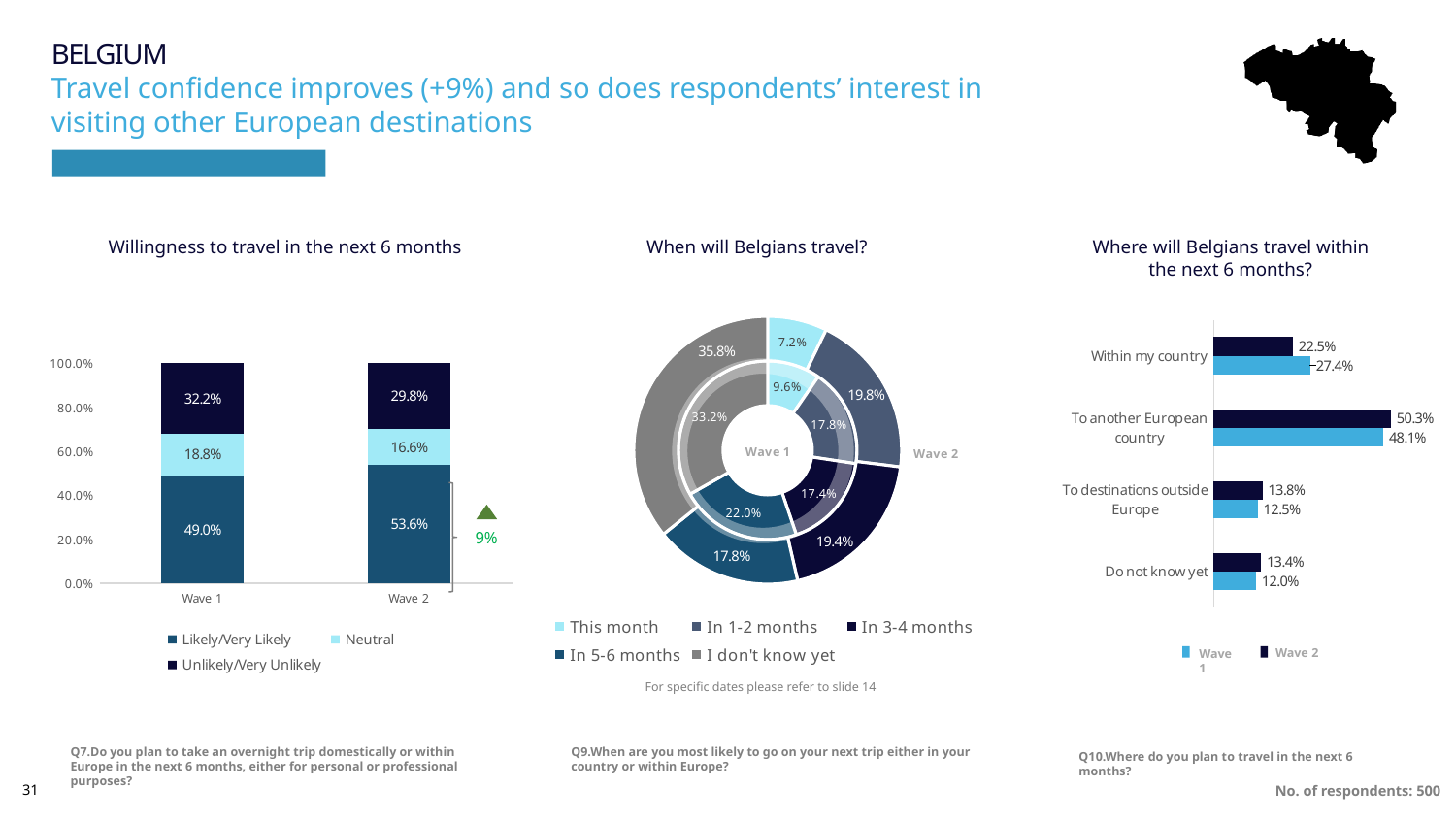
In the 'Where will Belgians travel within the next 6 months?' chart, how many categories are shown? 4 In the 'Where will Belgians travel within the next 6 months?' chart, what is the Wave 2 value for 'To another European country'? 50.3% In the 'Willingness to travel in the next 6 months' chart, what is the Neutral value for Wave 1? 18.8% In the 'When will Belgians travel?' chart, what is the Wave 2 share for 'I don't know yet'? 35.8% In the 'Willingness to travel in the next 6 months' chart, what is the Likely/Very Likely value for Wave 2? 53.6% In the 'Willingness to travel in the next 6 months' chart, how many series does the legend list? 3 In the 'Willingness to travel in the next 6 months' chart, what is the difference between the Unlikely/Very Unlikely values for Wave 1 and Wave 2? 2.4% In the 'When will Belgians travel?' chart, what is the Wave 1 share for 'This month'? 9.6% In the 'When will Belgians travel?' chart, how many entries does the legend list? 5 In the 'Where will Belgians travel within the next 6 months?' chart, which category has the highest value? To another European country In the 'Where will Belgians travel within the next 6 months?' chart, which is larger for 'Within my country': Wave 1 or Wave 2? Wave 1 What kind of chart is 'When will Belgians travel?' Doughnut chart